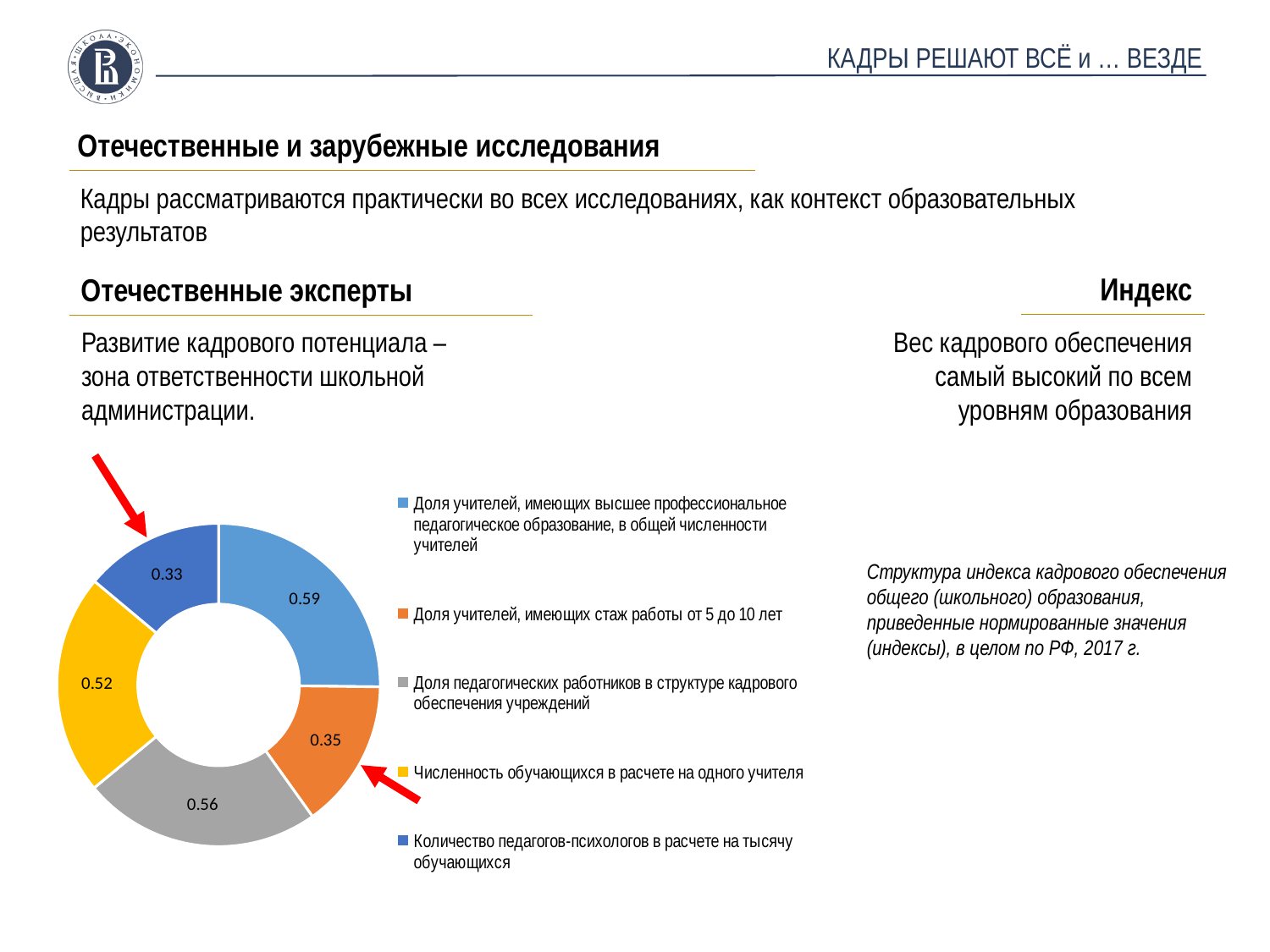
What is the value for 'Доля учителей, имеющих высшее профессиональное педагогическое образование, в общей численности учителей'? 0.59 What type of chart is shown on the slide? Doughnut chart Which is larger: the value for 'Численность обучающихся в расчете на одного учителя' or the value for 'Количество педагогов-психологов в расчете на тысячу обучающихся'? Численность обучающихся в расчете на одного учителя What is the value for 'Количество педагогов-психологов в расчете на тысячу обучающихся'? 0.33 Which category has the highest value in the doughnut chart? Доля учителей, имеющих высшее профессиональное педагогическое образование, в общей численности учителей What is the value for 'Доля учителей, имеющих стаж работы от 5 до 10 лет'? 0.35 How many entries does the legend of the doughnut chart list? 5 What is the value for 'Численность обучающихся в расчете на одного учителя'? 0.52 What is the difference between the values for 'Доля педагогических работников в структуре кадрового обеспечения учреждений' and 'Доля учителей, имеющих стаж работы от 5 до 10 лет'? 0.21 What is the value for 'Доля педагогических работников в структуре кадрового обеспечения учреждений'? 0.56 Which category has the lowest value in the doughnut chart? Количество педагогов-психологов в расчете на тысячу обучающихся How many slices does the doughnut chart have? 5